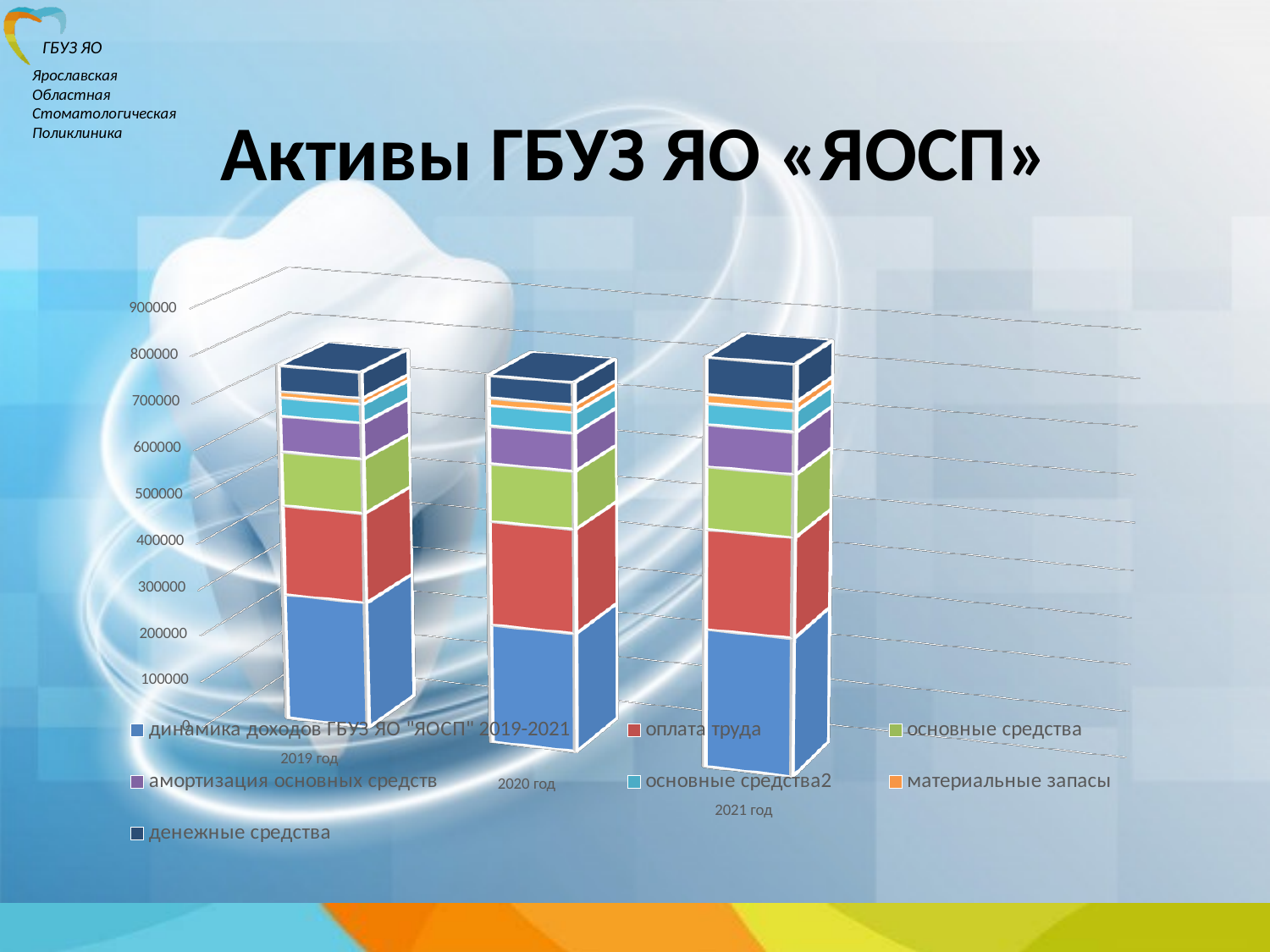
How many year categories are plotted along the x axis? 3 What is the title of the slide containing the chart? Активы ГБУЗ ЯО «ЯОСП» How many series does the legend list? 7 Is the total height of the 2021 год bar greater or less than 400000? greater Is the total height of the 2020 год bar greater or less than 900000? less Is the total height of the 2019 год bar greater or less than 500000? greater What is the highest value shown on the vertical axis? 900000 What kind of chart is shown on the slide? stacked bar chart Which legend entry is shown in red? оплата труда Which years are shown as categories on the x axis? 2019 год, 2020 год, 2021 год